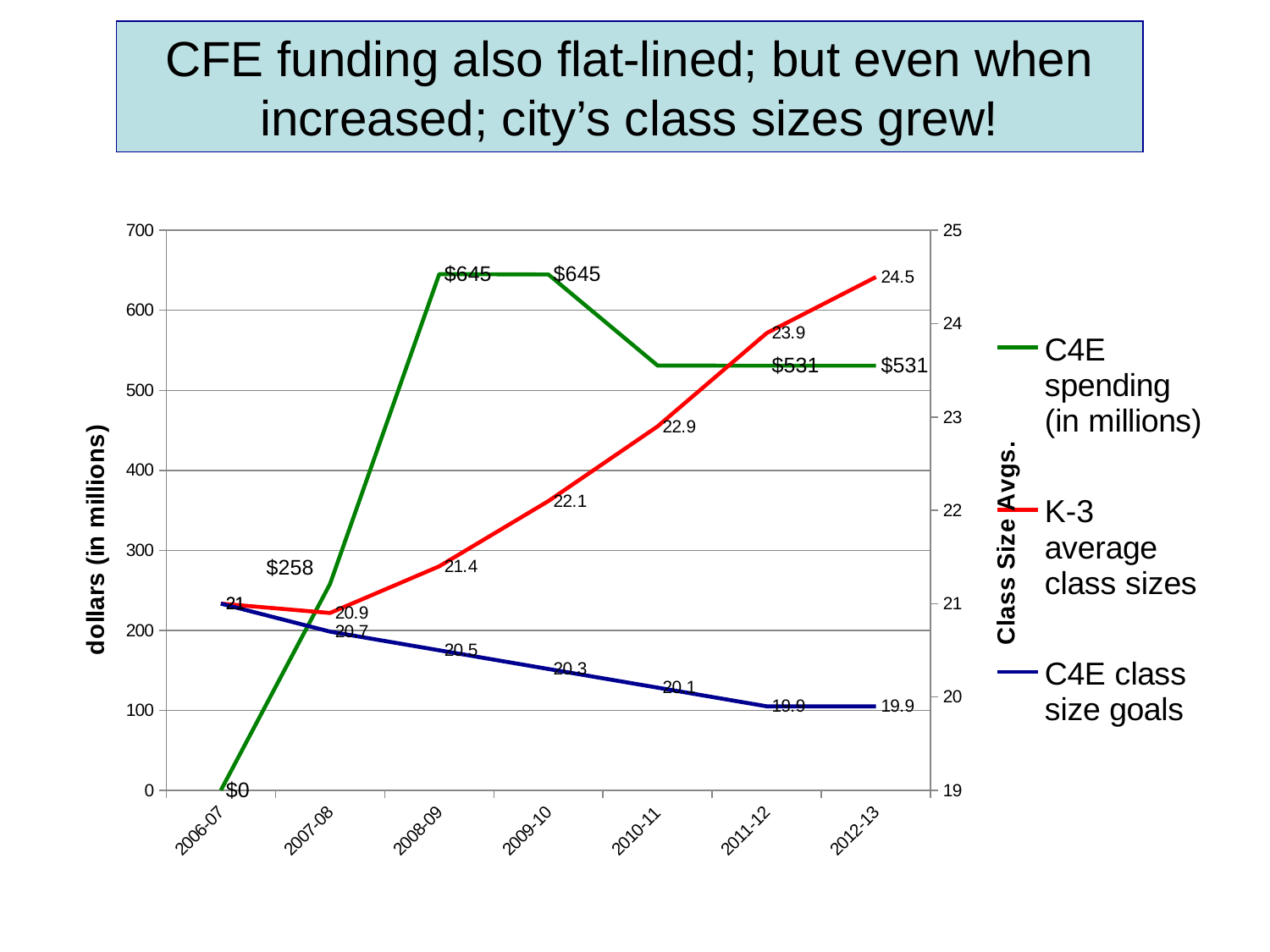
What is the difference between the K-3 average class size and the C4E class size goal in 2012-13? 4.6 What was C4E spending (in millions) in 2007-08? $258 Which was larger in 2009-10: the K-3 average class size or the C4E class size goal? K-3 average class size In which year was C4E spending (in millions) lowest? 2006-07 How many years are shown on the x axis? 7 What was the K-3 average class size in 2012-13? 24.5 What kind of chart is shown on the slide? Line chart In which year was the K-3 average class size highest? 2012-13 What was the C4E class size goal for 2010-11? 20.1 How many series does the legend list? 3 Do the C4E class size goals rise or fall from 2006-07 to 2012-13? Fall What was C4E spending (in millions) in 2008-09? $645